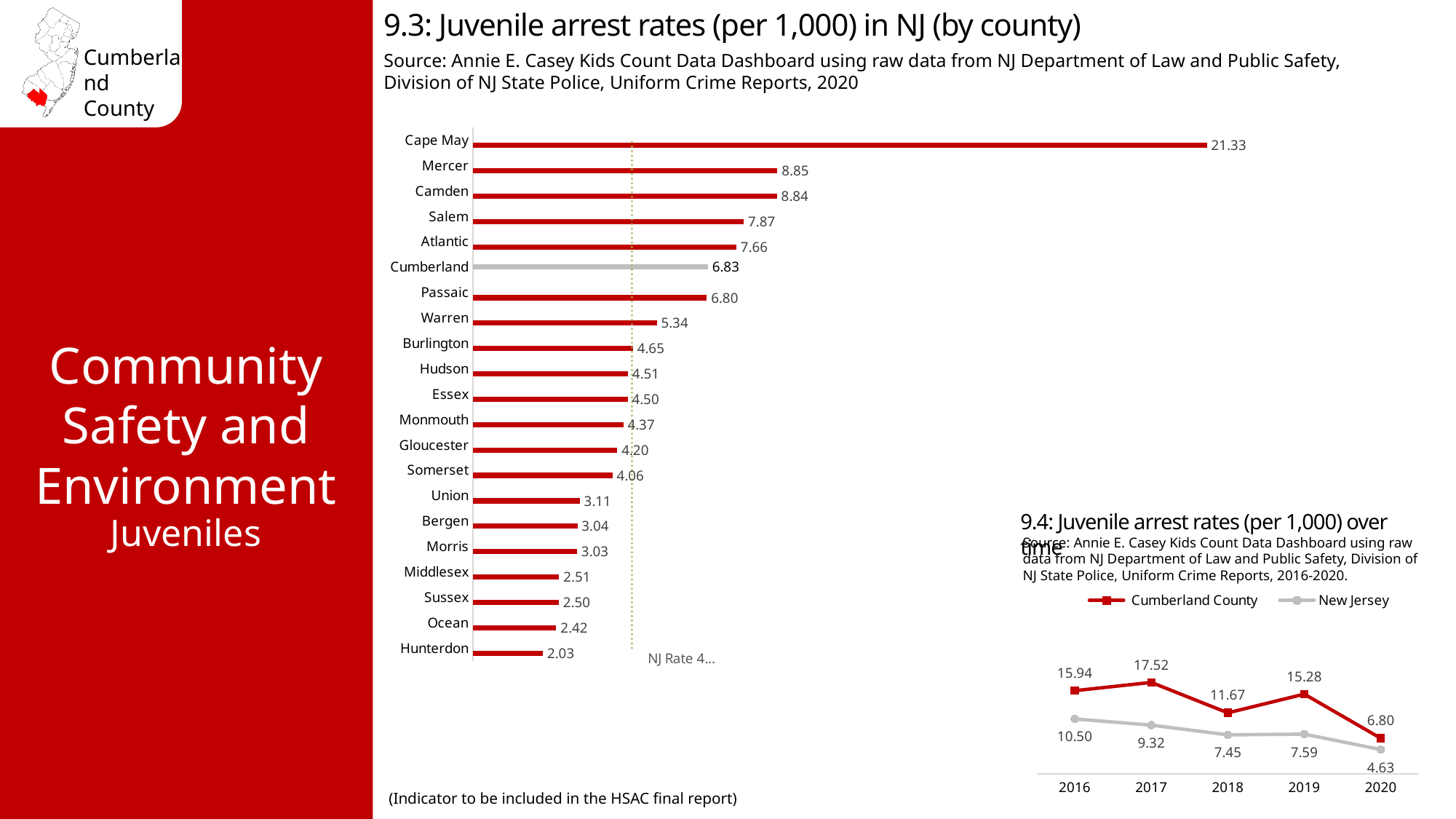
In chart 9.4 (juvenile arrest rates over time), what is the difference between the Cumberland County and New Jersey rates in 2020? 2.17 In chart 9.3 (juvenile arrest rates by county), what is the difference between the rates for Cape May and Hunterdon? 19.30 In chart 9.3 (juvenile arrest rates by county), what is the juvenile arrest rate for Cumberland? 6.83 In chart 9.3 (juvenile arrest rates by county), which county has a higher rate, Salem or Passaic? Salem In chart 9.4 (juvenile arrest rates over time), how many series does the legend list? 2 In chart 9.3 (juvenile arrest rates by county), how many counties are shown? 21 In chart 9.4 (juvenile arrest rates over time), what was the Cumberland County rate in 2017? 17.52 What kind of chart is chart 9.3 (juvenile arrest rates by county)? Bar chart In chart 9.3 (juvenile arrest rates by county), which county has the lowest juvenile arrest rate? Hunterdon In chart 9.4 (juvenile arrest rates over time), what was the New Jersey rate in 2020? 4.63 In chart 9.4 (juvenile arrest rates over time), does the New Jersey rate rise or fall from 2016 to 2020? Fall In chart 9.3 (juvenile arrest rates by county), which county has the highest juvenile arrest rate? Cape May